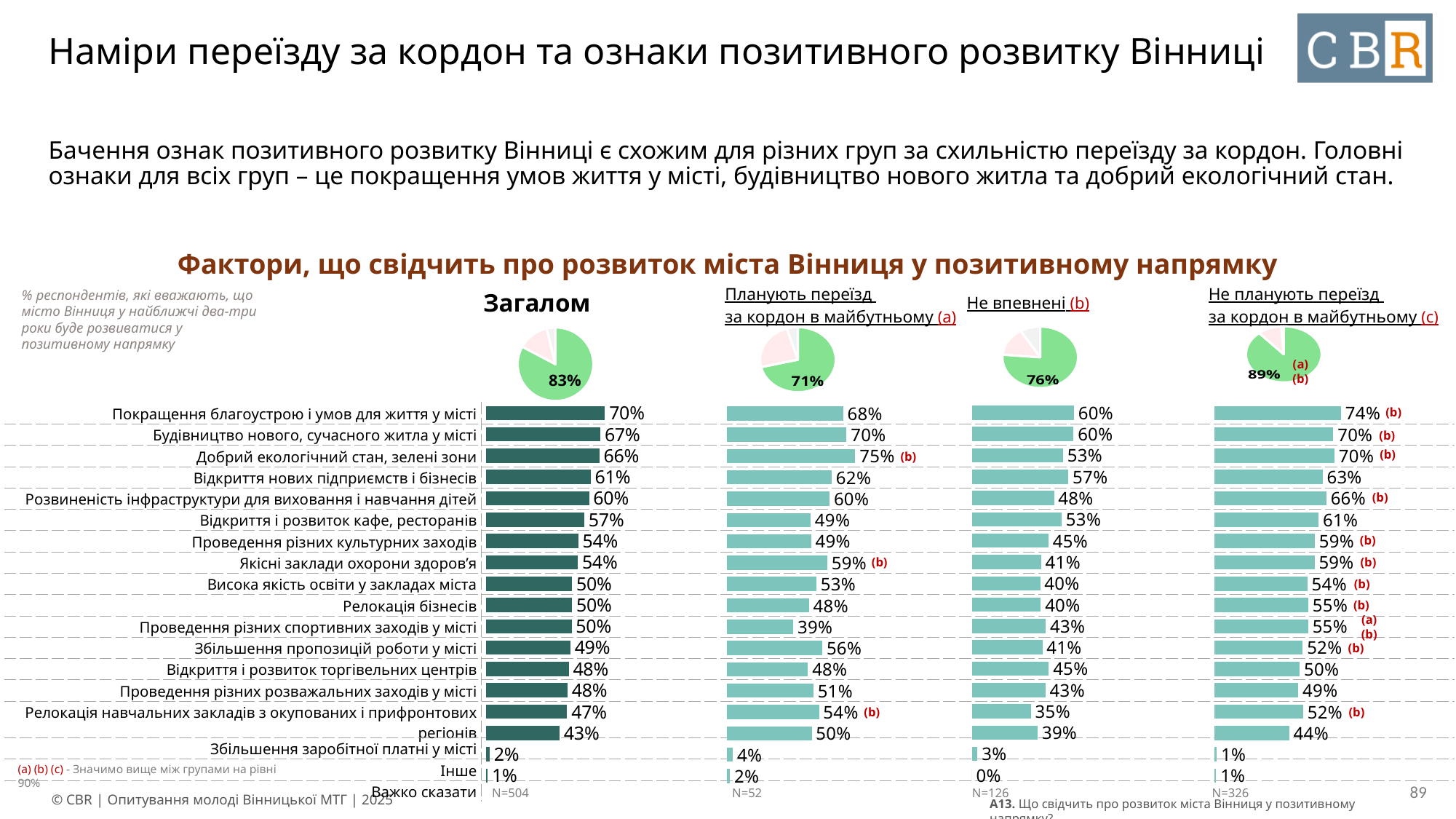
What kind of chart is used to show the factors in the 'Загалом' column? Bar chart What percentage is shown in the pie chart for the 'Загалом' group? 83% For 'Добрий екологічний стан, зелені зони', which group has the larger value: 'Планують переїзд за кордон в майбутньому' or 'Не впевнені'? Планують переїзд за кордон в майбутньому What is the sample size (N) shown for the 'Планують переїзд за кордон в майбутньому' group? N=52 What is the difference between the 'Загалом' value (70%) and the 'Планують переїзд за кордон в майбутньому' value (68%) for 'Покращення благоустрою і умов для життя у місті'? 2 percentage points In the 'Не планують переїзд за кордон в майбутньому' chart, what is the value for 'Відкриття нових підприємств і бізнесів'? 63% In the 'Загалом' chart, what is the value for 'Покращення благоустрою і умов для життя у місті'? 70% In the 'Планують переїзд за кордон в майбутньому' chart, which factor has the highest value? Добрий екологічний стан, зелені зони In the 'Загалом' chart, which factor has the highest value? Покращення благоустрою і умов для життя у місті Which group's pie chart shows the highest share of respondents who believe Vinnytsia will develop positively? Не планують переїзд за кордон в майбутньому (89%) In the 'Планують переїзд за кордон в майбутньому' chart, what is the value for 'Добрий екологічний стан, зелені зони'? 75% In the 'Не впевнені' chart, what is the value for 'Добрий екологічний стан, зелені зони'? 53%